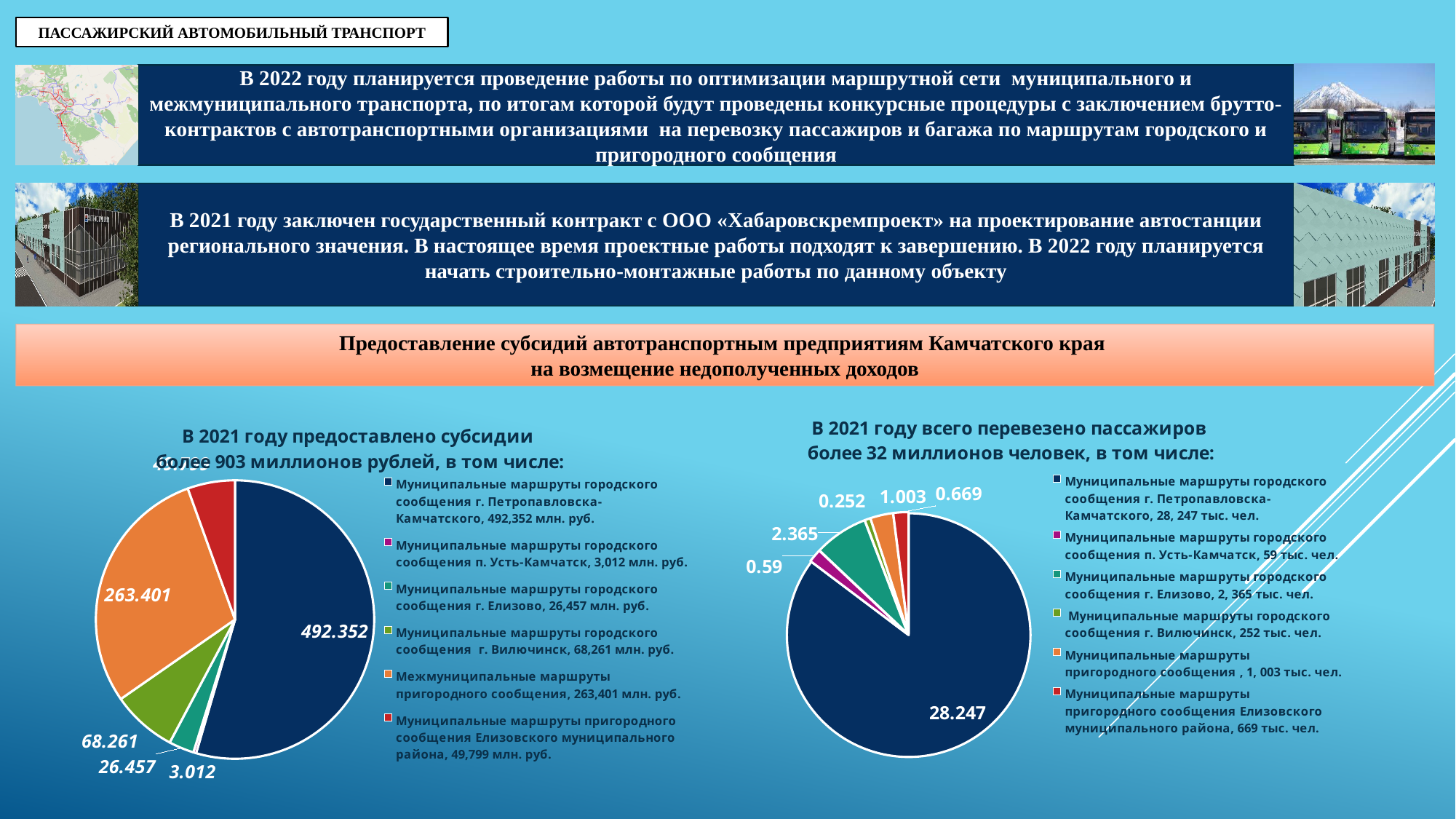
In the left chart (subsidies in 2021), which category has the largest slice? Муниципальные маршруты городского сообщения г. Петропавловска-Камчатского In the left chart (subsidies in 2021), which category has the smallest slice? Муниципальные маршруты городского сообщения п. Усть-Камчатск In the right chart (passengers carried in 2021), what is the difference between the value for Муниципальные маршруты пригородного сообщения (1.003) and the value for Муниципальные маршруты пригородного сообщения Елизовского муниципального района (0.669)? 0.334 How many entries does the legend of the right chart (passengers carried in 2021) list? 6 In the right chart (passengers carried in 2021), what value is shown for Муниципальные маршруты городского сообщения г. Елизово? 2.365 In the left chart (subsidies in 2021), which is larger: the value for г. Вилючинск or the value for г. Елизово? г. Вилючинск In the right chart (passengers carried in 2021), which category has the largest slice? Муниципальные маршруты городского сообщения г. Петропавловска-Камчатского In the right chart (passengers carried in 2021), which category has the smallest slice? Муниципальные маршруты городского сообщения г. Вилючинск What kind of chart is the left chart titled «В 2021 году предоставлено субсидии более 903 миллионов рублей»? Pie chart In the left chart (subsidies in 2021), what value is shown for Муниципальные маршруты городского сообщения г. Петропавловска-Камчатского? 492.352 In the left chart (subsidies in 2021), what is the difference between the value for Межмуниципальные маршруты пригородного сообщения (263.401) and the value for г. Вилючинск (68.261)? 195.140 How many slices does the left chart (subsidies in 2021) have? 6